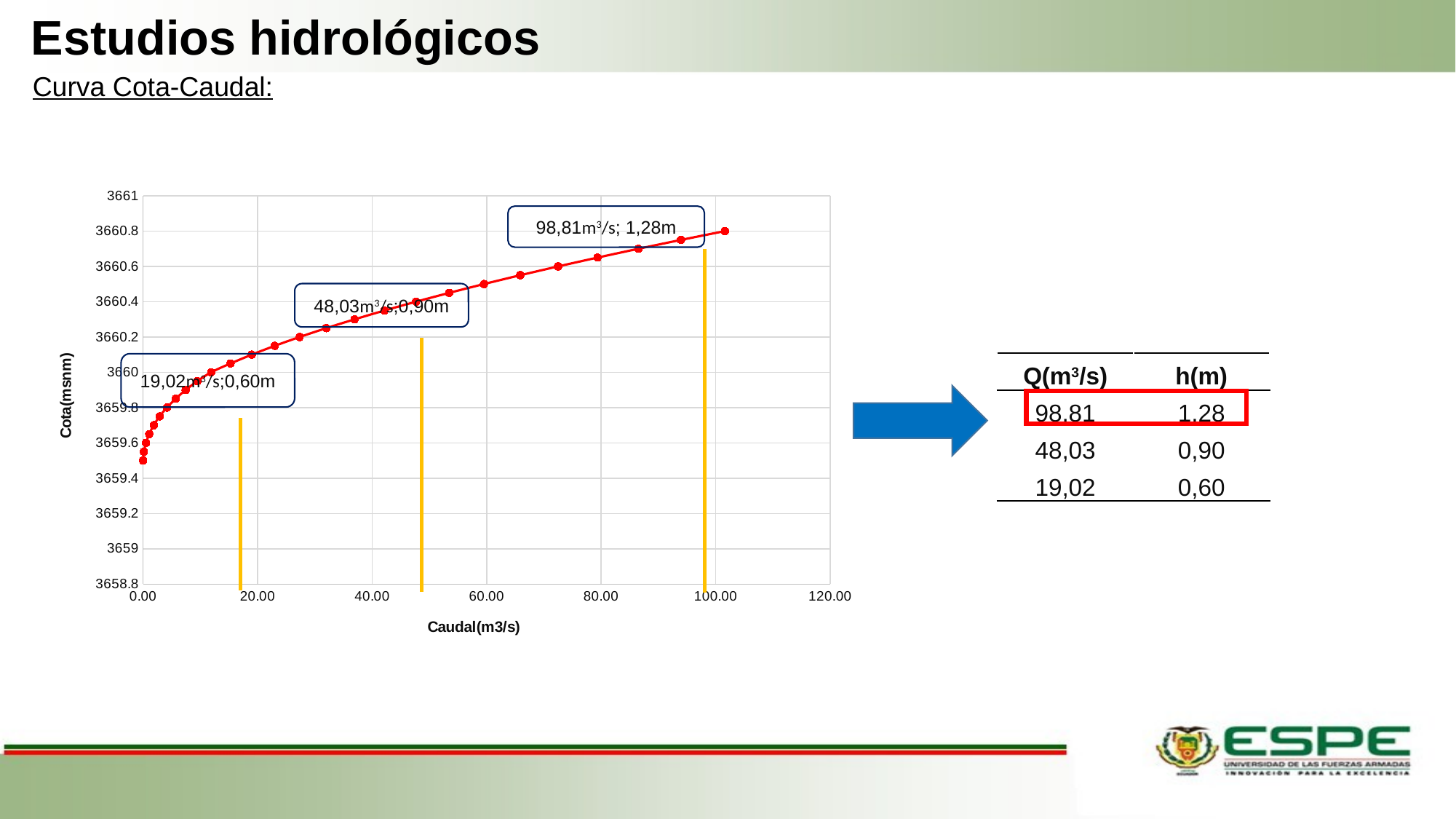
What flow value is annotated on the curve together with a depth of 0,60m? 19,02m³/s Does the plotted curve rise or fall as Caudal increases along the x axis? rises Is the Cota value of the curve at a Caudal of about 100 m³/s greater or less than 3660.6? greater Which of the three annotated points has the lowest depth h? 19,02m³/s; 0,60m What is the difference in depth h between the annotated points at 98,81 m³/s and 19,02 m³/s? 0,68m What depth h is annotated on the curve for a flow of 98,81 m³/s? 1,28m What depth h is annotated on the curve for a flow of 48,03 m³/s? 0,90m What is the label of the y axis of the chart? Cota(msnm) What kind of chart is shown on the slide? line chart Which of the three annotated points has the highest flow (Caudal)? 98,81m³/s What is the label of the x axis of the chart? Caudal(m3/s) How many annotated points (callout boxes) are marked on the curve? 3